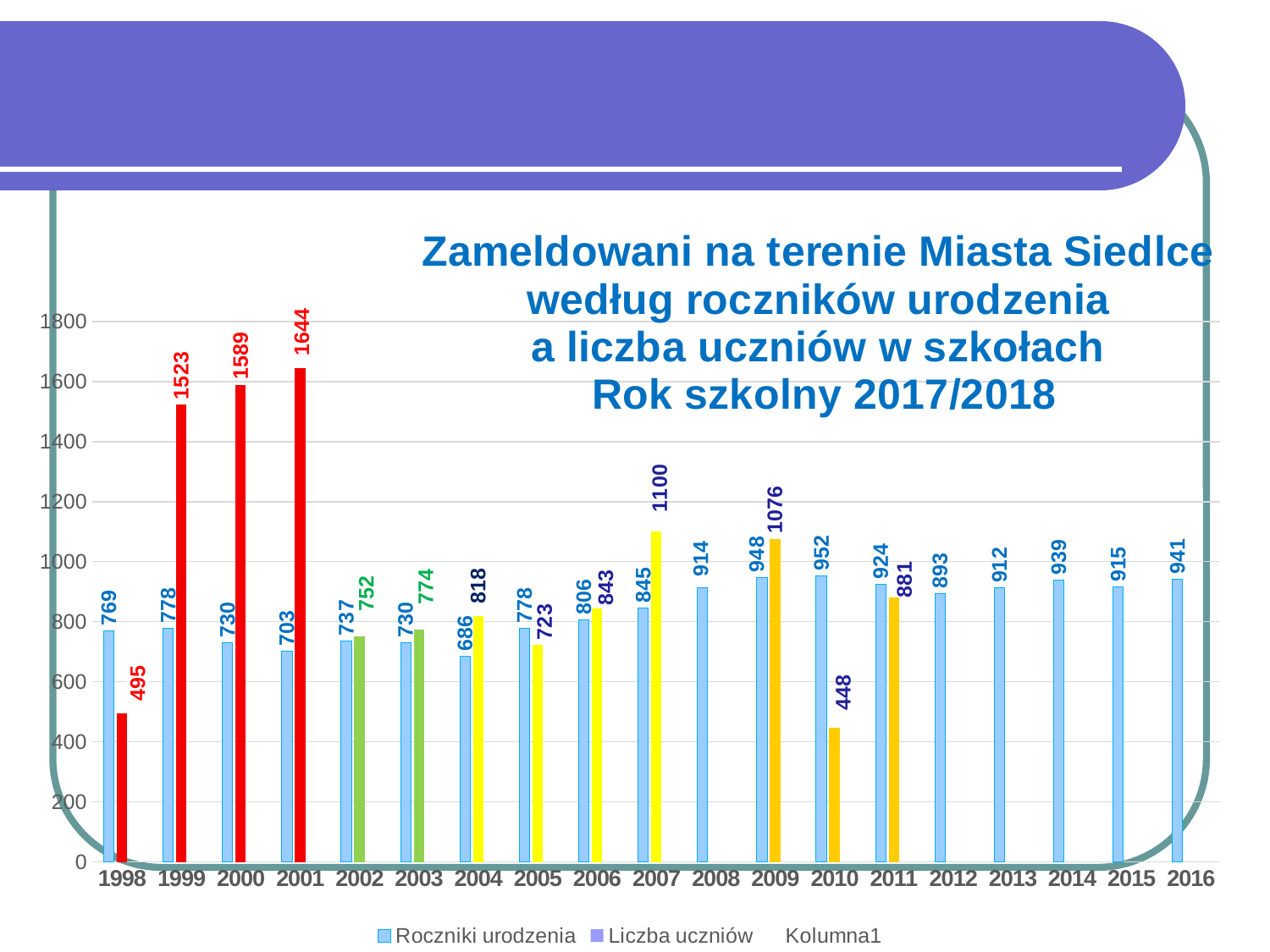
What is the value of Roczniki urodzenia for 2010? 952 Which year has the highest value for Liczba uczniów? 2001 How many years are shown on the x axis? 19 What is the difference between Liczba uczniów and Roczniki urodzenia for 2001? 941 Is the value of Liczba uczniów for 1999 greater or less than 1400? greater Which year has the lowest value for Liczba uczniów? 2010 What is the value of Liczba uczniów for 2001? 1644 Which year has the lowest value for Roczniki urodzenia? 2004 What is the value of Liczba uczniów for 1998? 495 For 2007, which is larger: Roczniki urodzenia or Liczba uczniów? Liczba uczniów How many series does the legend list? 3 What kind of chart is shown on the slide? bar chart